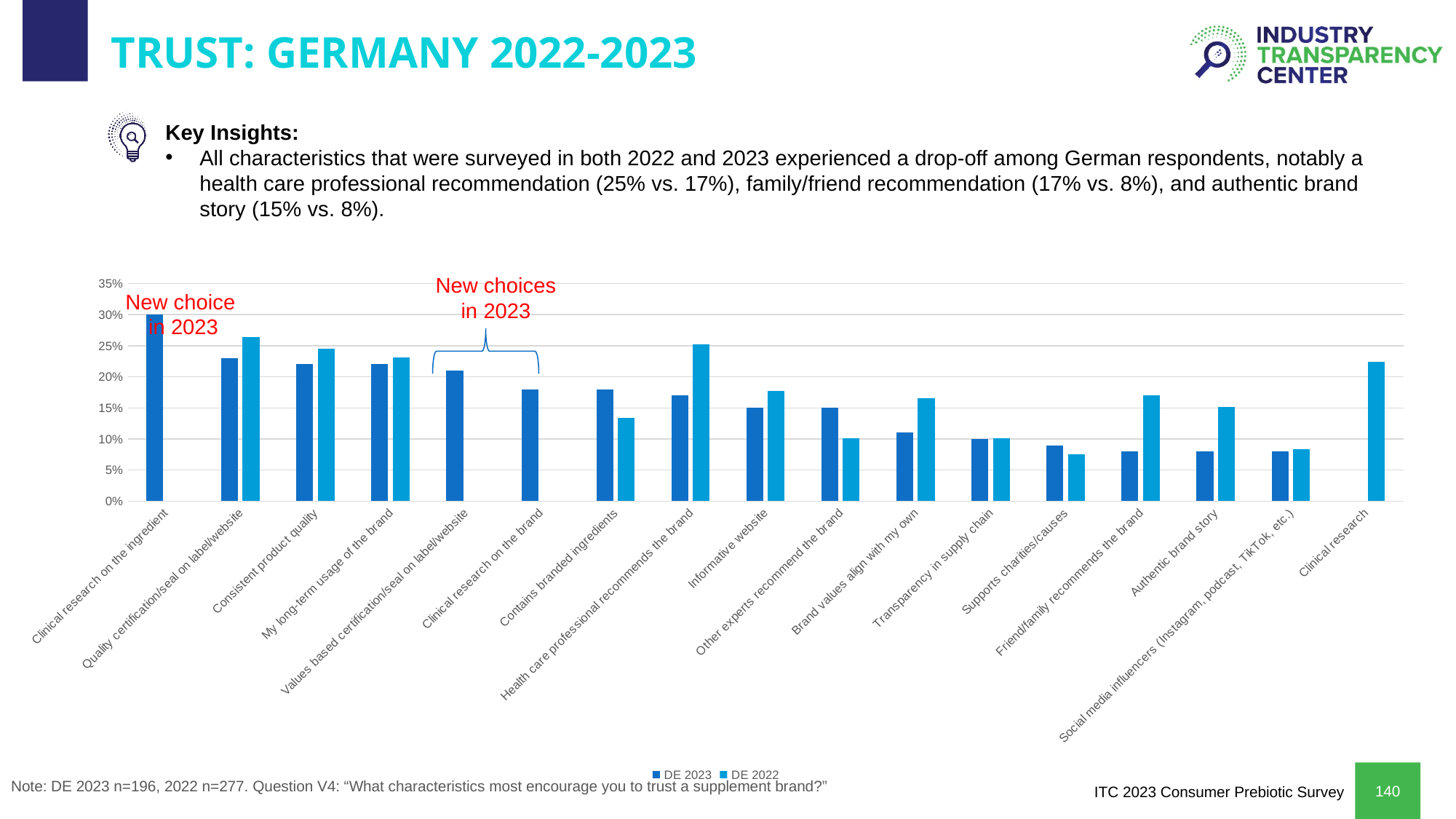
Is the DE 2022 value for Contains branded ingredients greater or less than 15%? less What is the DE 2023 value for Clinical research on the ingredient? 30% How many series does the chart legend list? 2 For Contains branded ingredients, which series has the larger value, DE 2023 or DE 2022? DE 2023 Is the DE 2022 value for Quality certification/seal on label/website greater or less than 25%? greater Which category on the chart has only a DE 2022 bar and no DE 2023 bar? Clinical research Which category has the highest DE 2023 value? Clinical research on the ingredient What is the DE 2023 value for Transparency in supply chain? 10% Is the DE 2023 value for Friend/family recommends the brand greater or less than 10%? less What kind of chart is shown on the slide? bar chart For Health care professional recommends the brand, which series has the larger value, DE 2023 or DE 2022? DE 2022 How many categories are shown along the x axis of the chart? 17